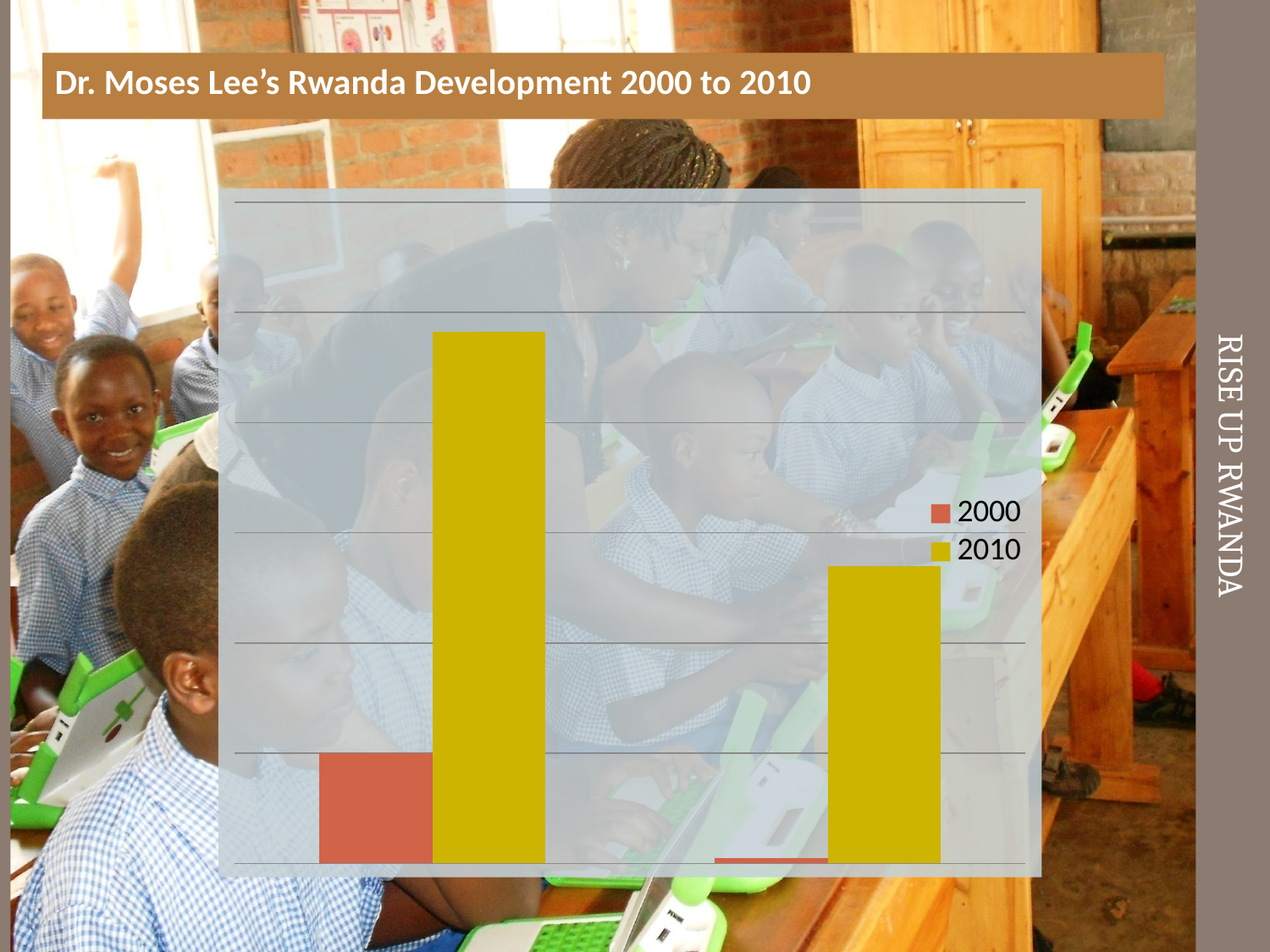
How many groups of bars (categories) are plotted in the chart? 2 Which years are listed in the chart's legend? 2000 and 2010 Which group of bars, left or right, has the taller 2000 bar? left Which group of bars, left or right, has the taller 2010 bar? left How many series does the chart's legend list? 2 For both groups of bars, do the values rise or fall from 2000 to 2010? rise What kind of chart is shown on the slide? bar chart Which single bar in the chart is the shortest? the 2000 bar in the right group In the left group of bars, which series has the larger value, 2000 or 2010? 2010 Which single bar in the chart is the tallest? the 2010 bar in the left group Which colour represents the 2010 series in the chart? yellow